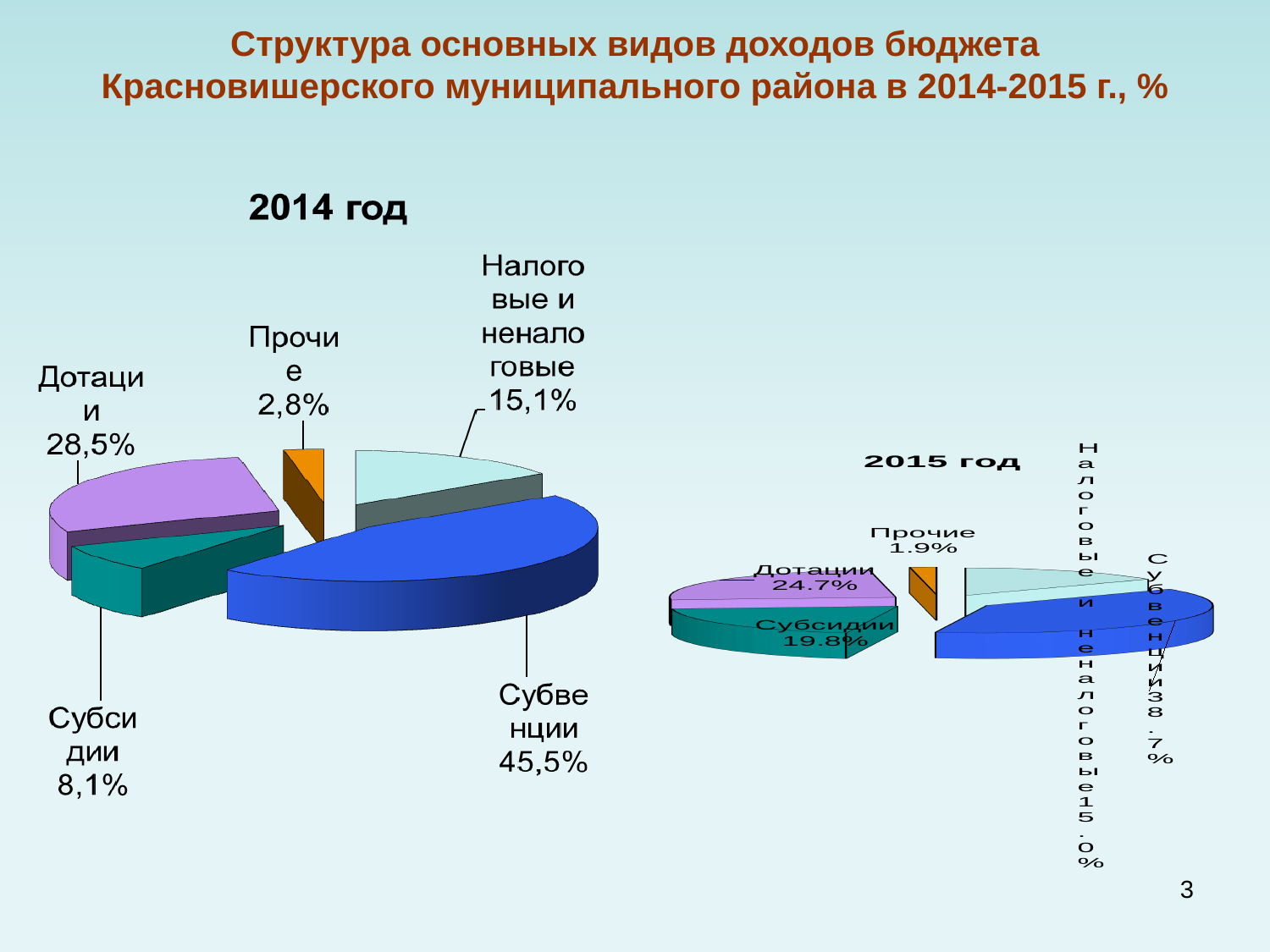
In the 2014 год chart, which category has the smallest share? Прочие In the 2015 год chart, what share do Субсидии have? 19.8% In the 2015 год chart, what share do Прочие have? 1.9% What type of chart is used for the 2014 год data? Pie chart In the 2014 год chart, which category has the largest share? Субвенции In the 2015 год chart, what share do Дотации have? 24.7% In the 2015 год chart, which is larger, Дотации or Субсидии? Дотации In the 2014 год chart, what share do Субвенции have? 45,5% In the 2014 год chart, how many slices does the pie have? 5 In the 2014 год chart, what is the difference between the shares of Дотации and Субсидии? 20,4% In the 2014 год chart, what share do Субсидии have? 8,1% In the 2014 год chart, what share do Дотации have? 28,5%